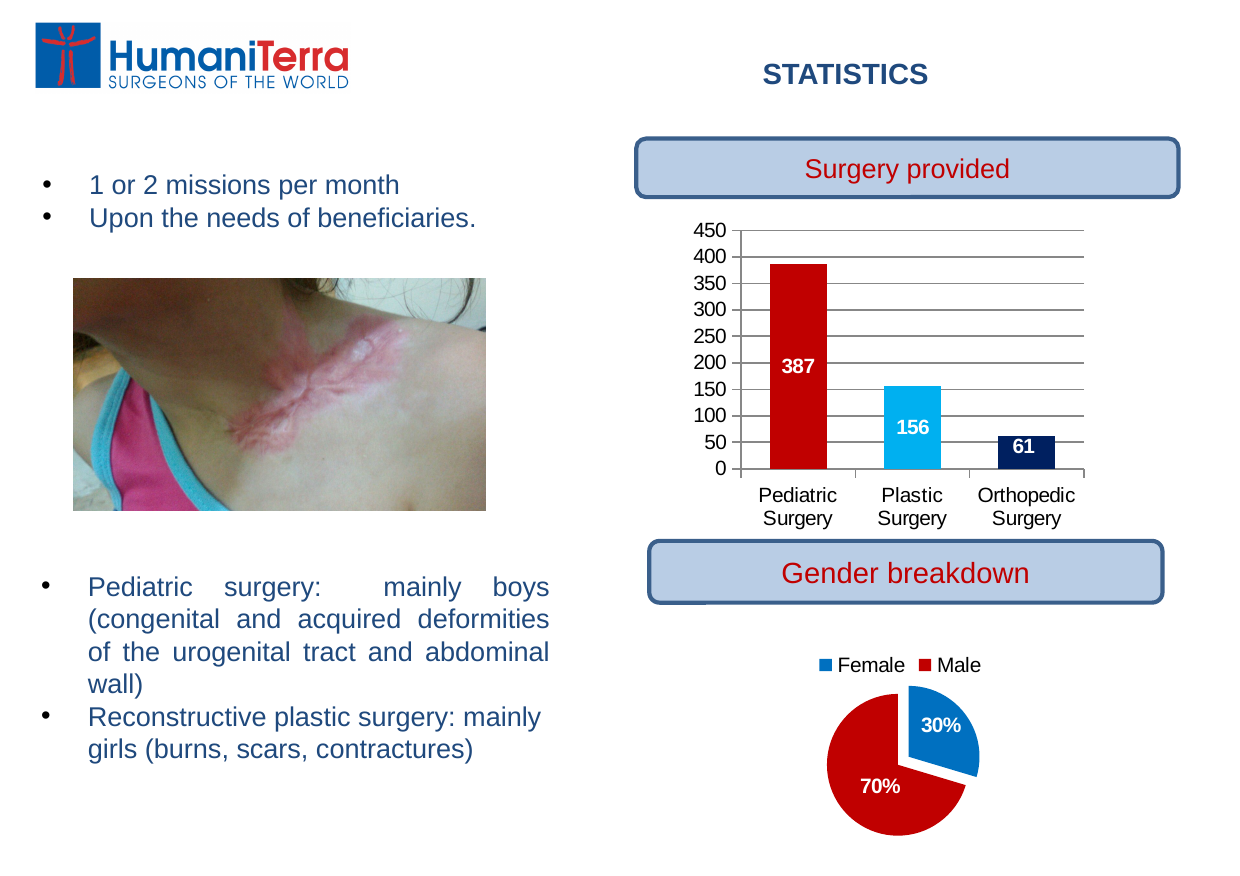
In the 'Surgery provided' chart, what is the value for Orthopedic Surgery? 61 In the 'Surgery provided' chart, how many categories are shown? 3 In the 'Surgery provided' chart, which category has the highest value? Pediatric Surgery What kind of chart is the 'Gender breakdown' chart? Pie chart In the 'Surgery provided' chart, what is the value for Plastic Surgery? 156 In the 'Surgery provided' chart, what is the value for Pediatric Surgery? 387 In the 'Surgery provided' chart, which is larger: Plastic Surgery or Orthopedic Surgery? Plastic Surgery What kind of chart is the 'Surgery provided' chart? Bar chart In the 'Gender breakdown' chart, what share is Male? 70% In the 'Surgery provided' chart, what is the difference between Pediatric Surgery and Plastic Surgery? 231 In the 'Surgery provided' chart, which category has the lowest value? Orthopedic Surgery In the 'Gender breakdown' chart, what share is Female? 30%